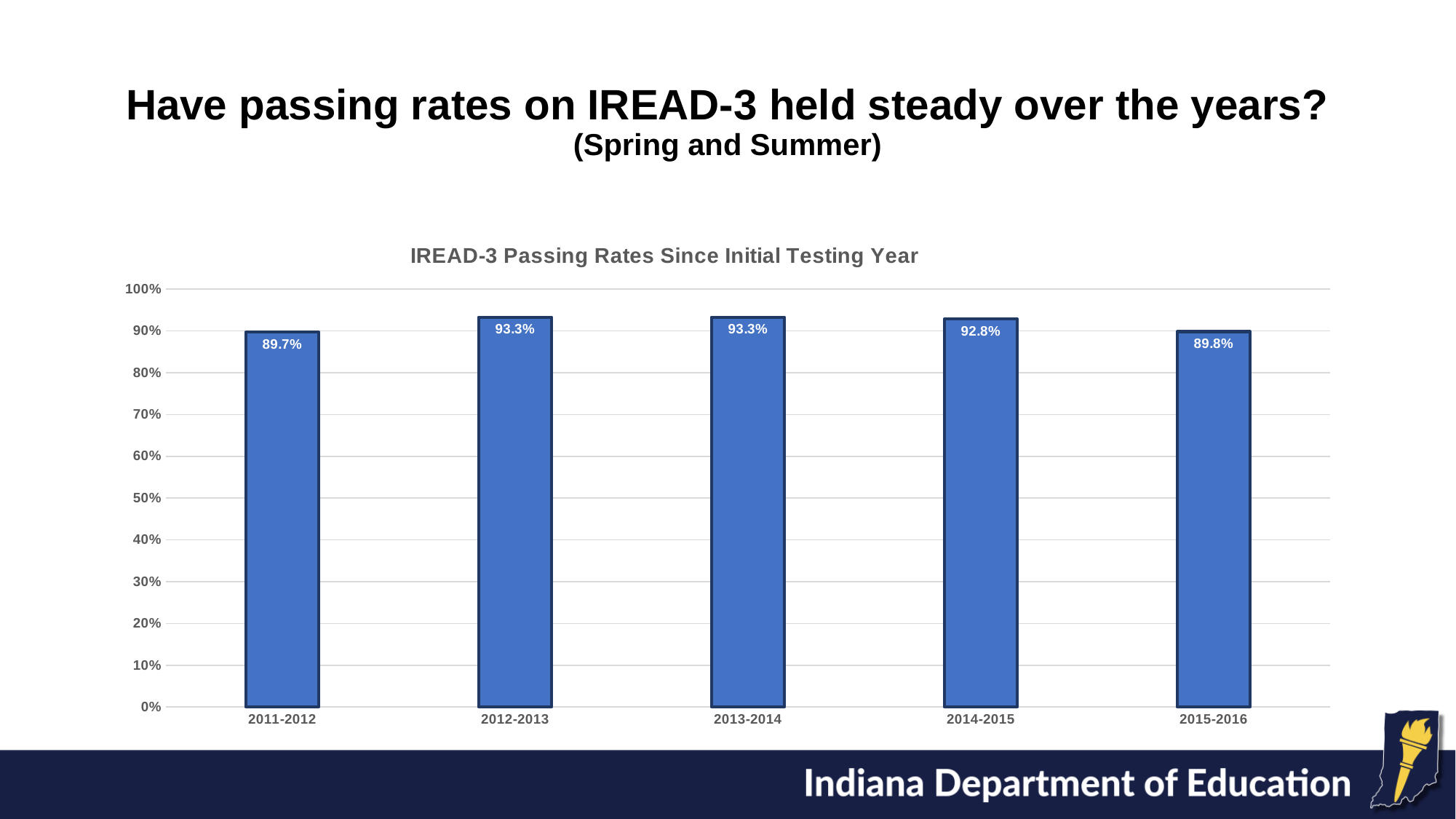
What kind of chart is shown on the slide? Bar chart What is the IREAD-3 passing rate for 2011-2012? 89.7% Which year has the lowest IREAD-3 passing rate? 2011-2012 What is the IREAD-3 passing rate for 2015-2016? 89.8% What is the difference between the passing rates for 2012-2013 and 2011-2012? 3.6% What is the IREAD-3 passing rate for 2014-2015? 92.8% Which is larger, the passing rate for 2014-2015 or for 2015-2016? 2014-2015 How many school years are shown on the chart? 5 Is the passing rate for 2012-2013 greater or less than 90%? greater What is the title of the chart? IREAD-3 Passing Rates Since Initial Testing Year What is the difference between the passing rates for 2013-2014 and 2015-2016? 3.5% What is the highest value shown on the vertical axis? 100%